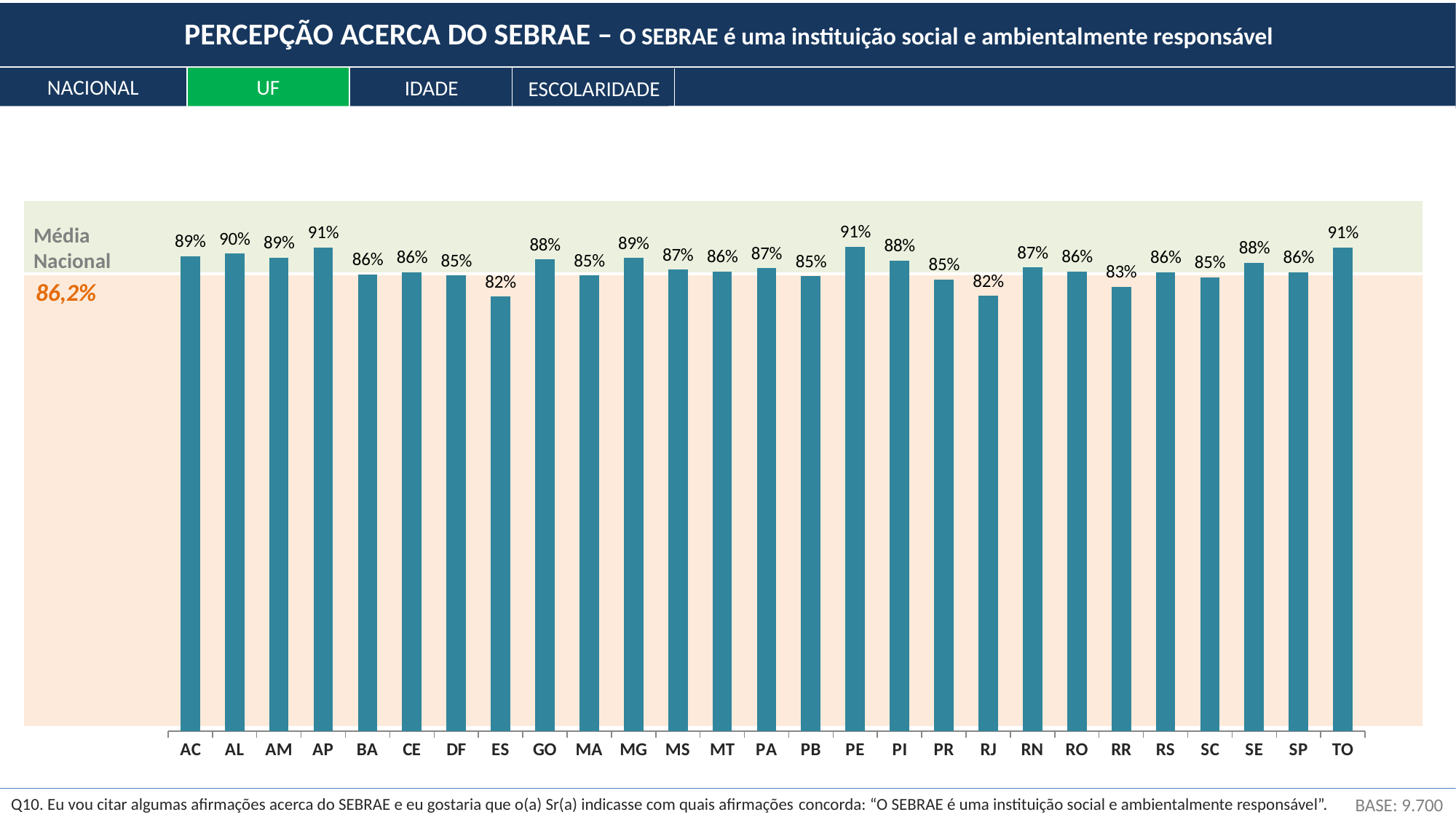
What is the difference between the values for AL and RR? 7% How many states (UF) are shown on the x axis? 27 What is the value for AL? 90% What is the value for RR? 83% What is the Média Nacional value shown on the chart? 86,2% What is the difference between the values for AP and ES? 9% Which states share the lowest value on the chart? ES and RJ Which states share the highest value on the chart? AP, PE and TO Which is larger, the value for GO or the value for PR? GO What kind of chart is shown on the slide? Bar chart What is the value for ES? 82% What is the value for SE? 88%